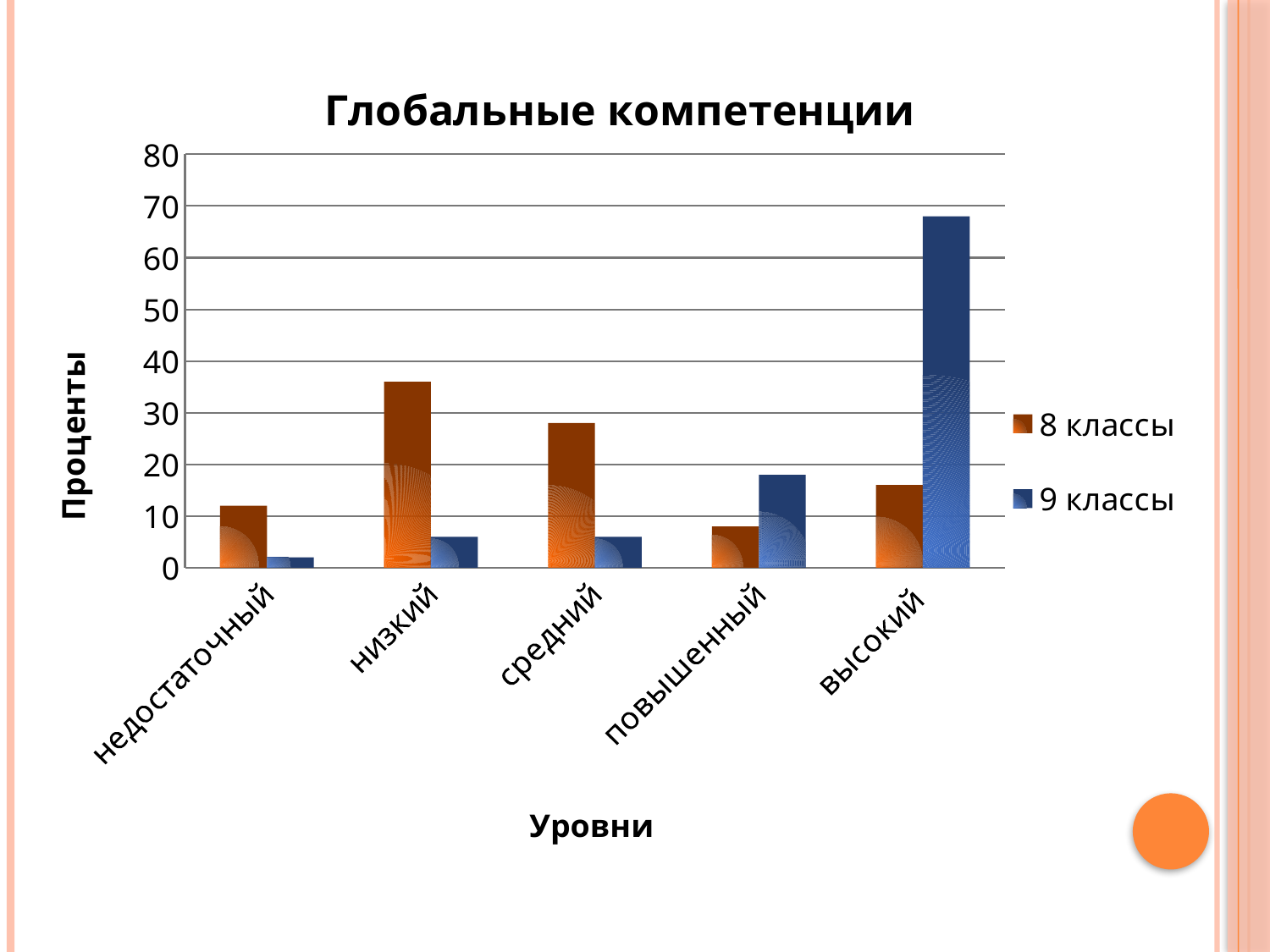
Is the value for 9 классы in the высокий category greater or less than 60? greater Is the value for 9 классы in the средний category greater or less than 10? less In the повышенный category, which series has the larger value, 8 классы or 9 классы? 9 классы How many categories are shown on the x axis? 5 What kind of chart is shown on the slide? bar chart Which category has the lowest value for 9 классы? недостаточный Which category has the lowest value for 8 классы? повышенный How many series does the legend list? 2 Which category has the highest value for 8 классы? низкий Is the value for 8 классы in the низкий category greater or less than 30? greater Which category has the highest value for 9 классы? высокий What is the title of the chart? Глобальные компетенции